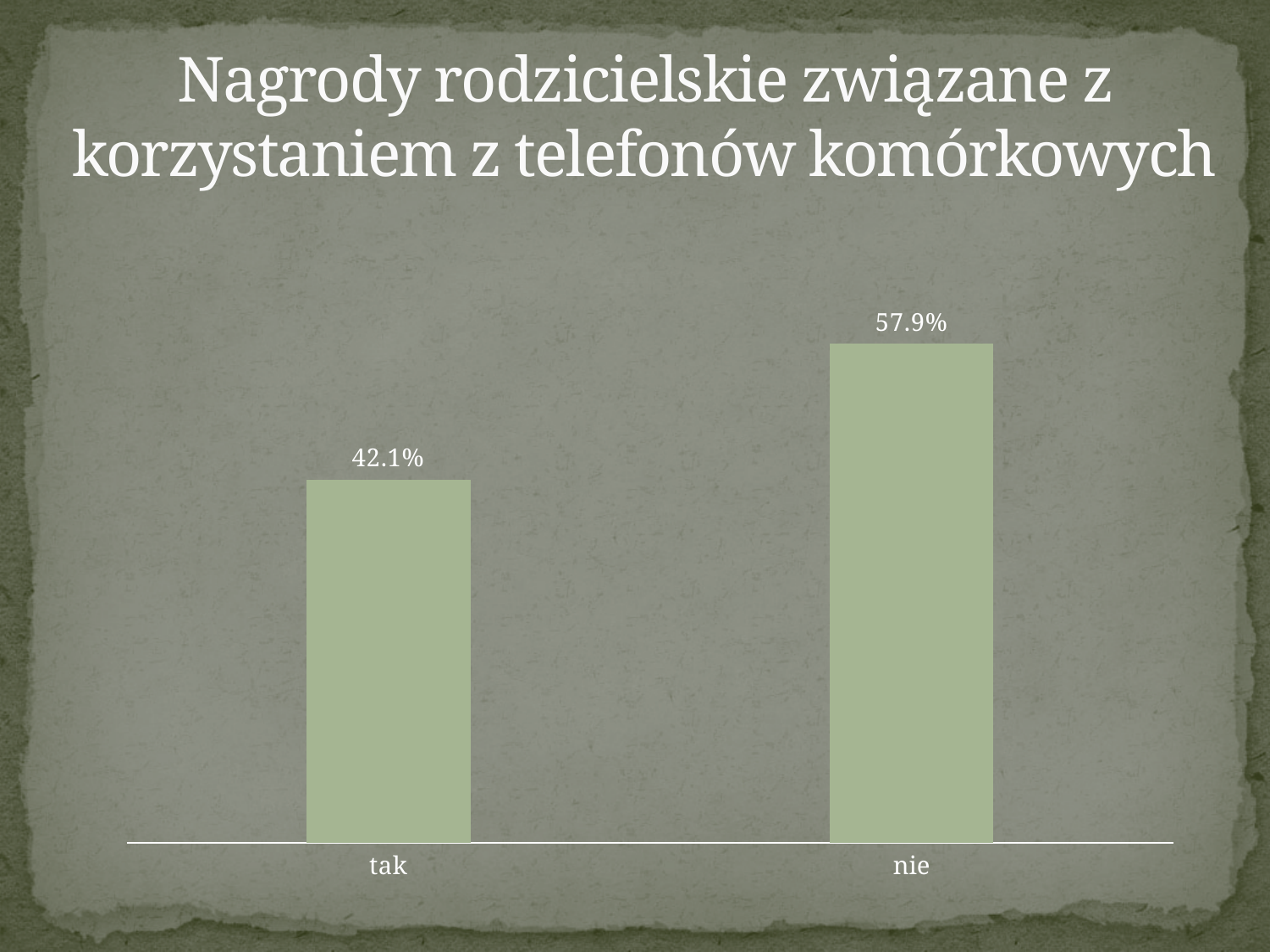
How many categories are shown in the chart? 2 What is the value for "nie"? 57.9% Do the values rise or fall from left to right along the x axis? rise Which category has the highest value? nie What kind of chart is shown on the slide? bar chart Which category has the lowest value? tak What is the value for "tak"? 42.1% Which is larger, the value for "tak" or the value for "nie"? nie What is the title of the slide? Nagrody rodzicielskie związane z korzystaniem z telefonów komórkowych What is the difference between the values for "nie" and "tak"? 15.8% What is the total of the two values shown in the chart? 100%